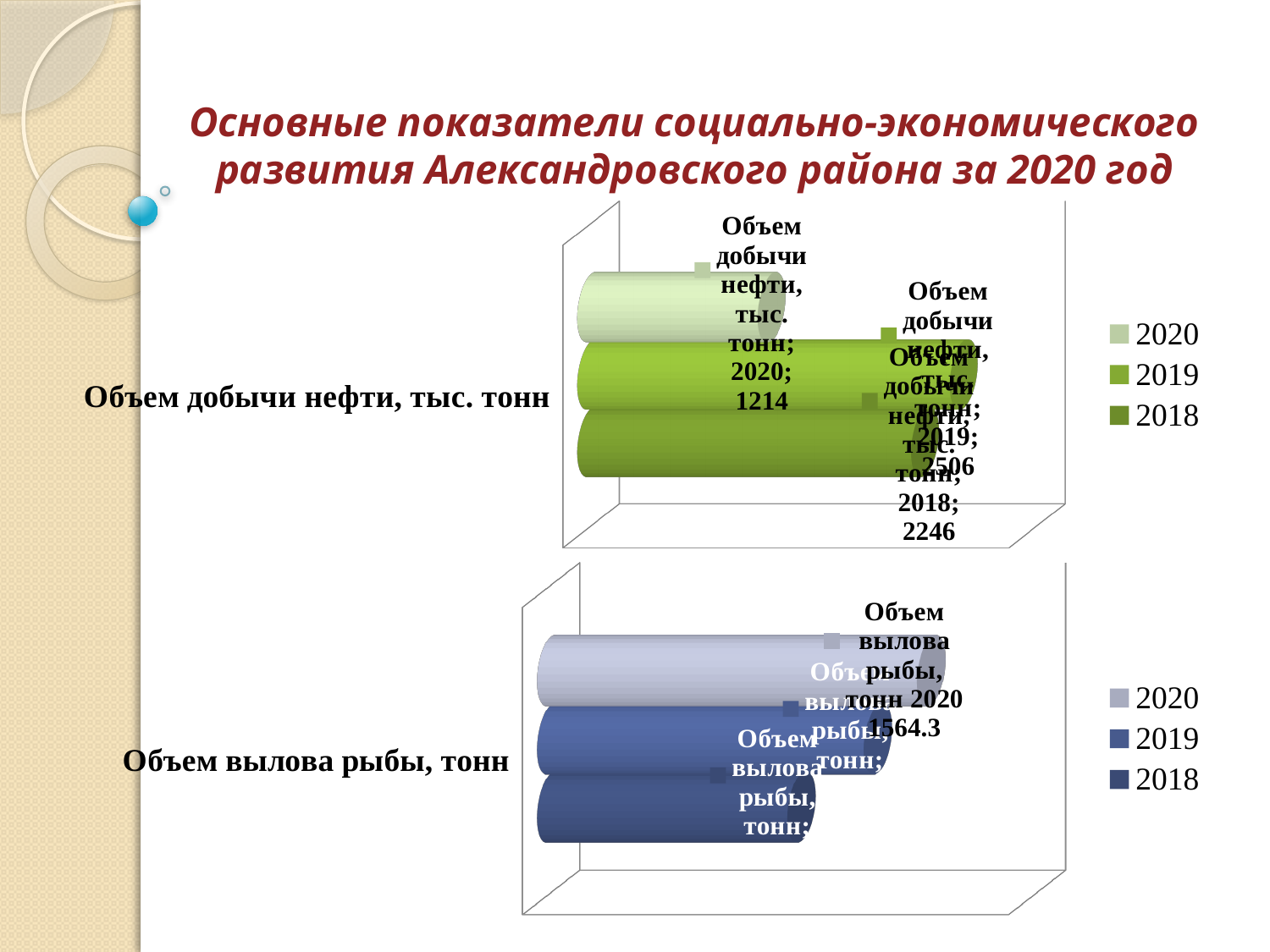
In the top chart (Объем добычи нефти, тыс. тонн), what is the value for 2019? 2506 In the top chart (Объем добычи нефти, тыс. тонн), which year has the lowest value? 2020 In the top chart (Объем добычи нефти, тыс. тонн), what is the value for 2020? 1214 In the top chart (Объем добычи нефти, тыс. тонн), which year has the highest value? 2019 In the bottom chart (Объем вылова рыбы, тонн), which year has the shortest bar? 2018 In the top chart (Объем добычи нефти, тыс. тонн), what is the difference between the 2019 and 2020 values? 1292 In the top chart (Объем добычи нефти, тыс. тонн), what is the value for 2018? 2246 In the top chart (Объем добычи нефти, тыс. тонн), what is the difference between the 2019 and 2018 values? 260 In the bottom chart (Объем вылова рыбы, тонн), what is the value for 2020? 1564.3 How many series does the legend of the top chart (Объем добычи нефти, тыс. тонн) list? 3 What kind of chart is the bottom chart (Объем вылова рыбы, тонн)? bar chart In the top chart (Объем добычи нефти, тыс. тонн), which is larger: the value for 2018 or for 2020? 2018